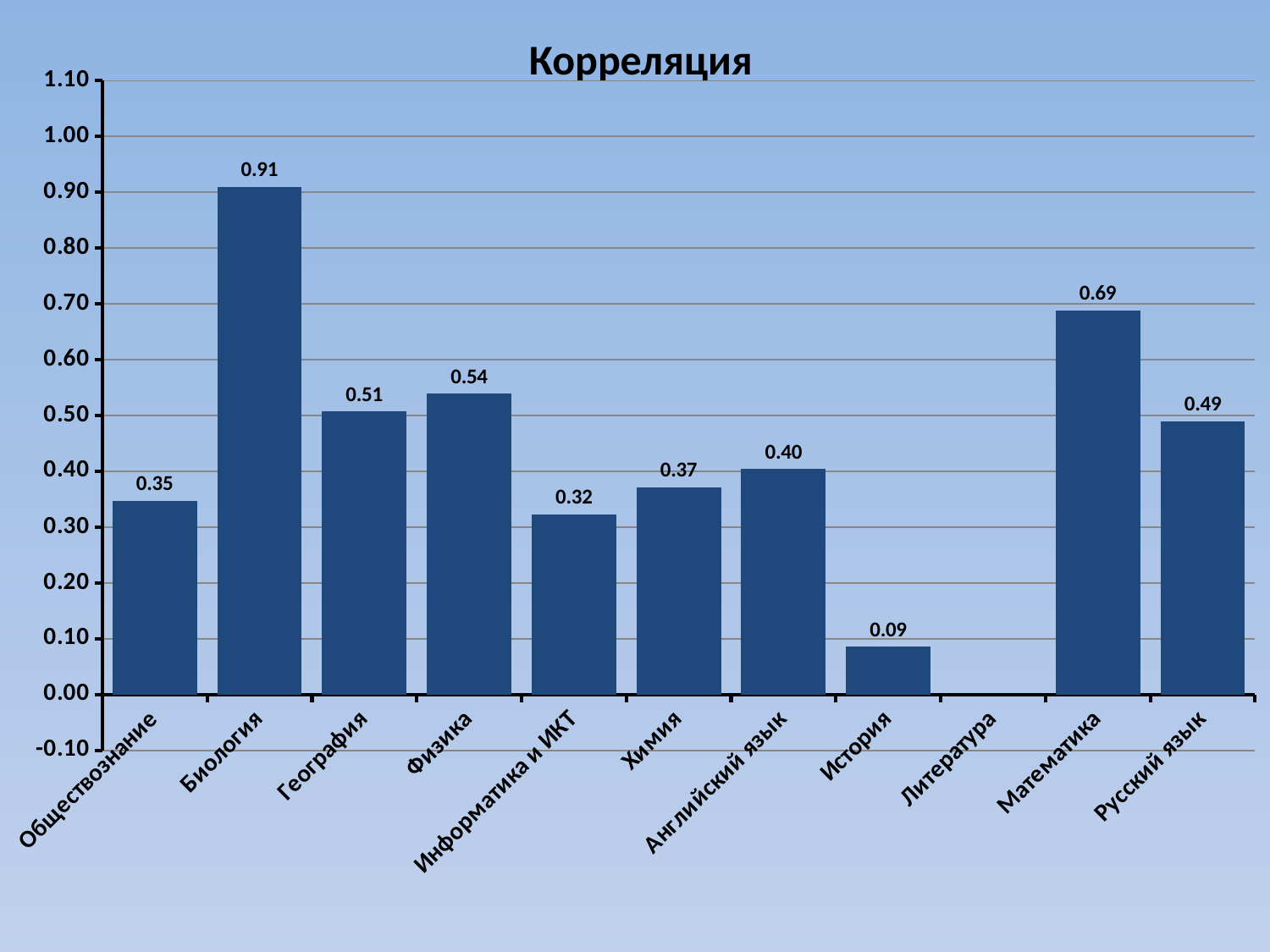
What is the title of the chart? Корреляция What is the value for Математика? 0.69 How many categories are shown on the x axis? 11 What kind of chart is this? bar chart Which category has the highest value? Биология What is the value for Информатика и ИКТ? 0.32 Is the value for Математика greater or less than 0.60? greater What is the value for История? 0.09 What is the difference between the values for Физика and География? 0.03 Which is larger, the value for Русский язык or the value for Английский язык? Русский язык What is the difference between the values for Биология and Математика? 0.22 What is the value for Биология? 0.91